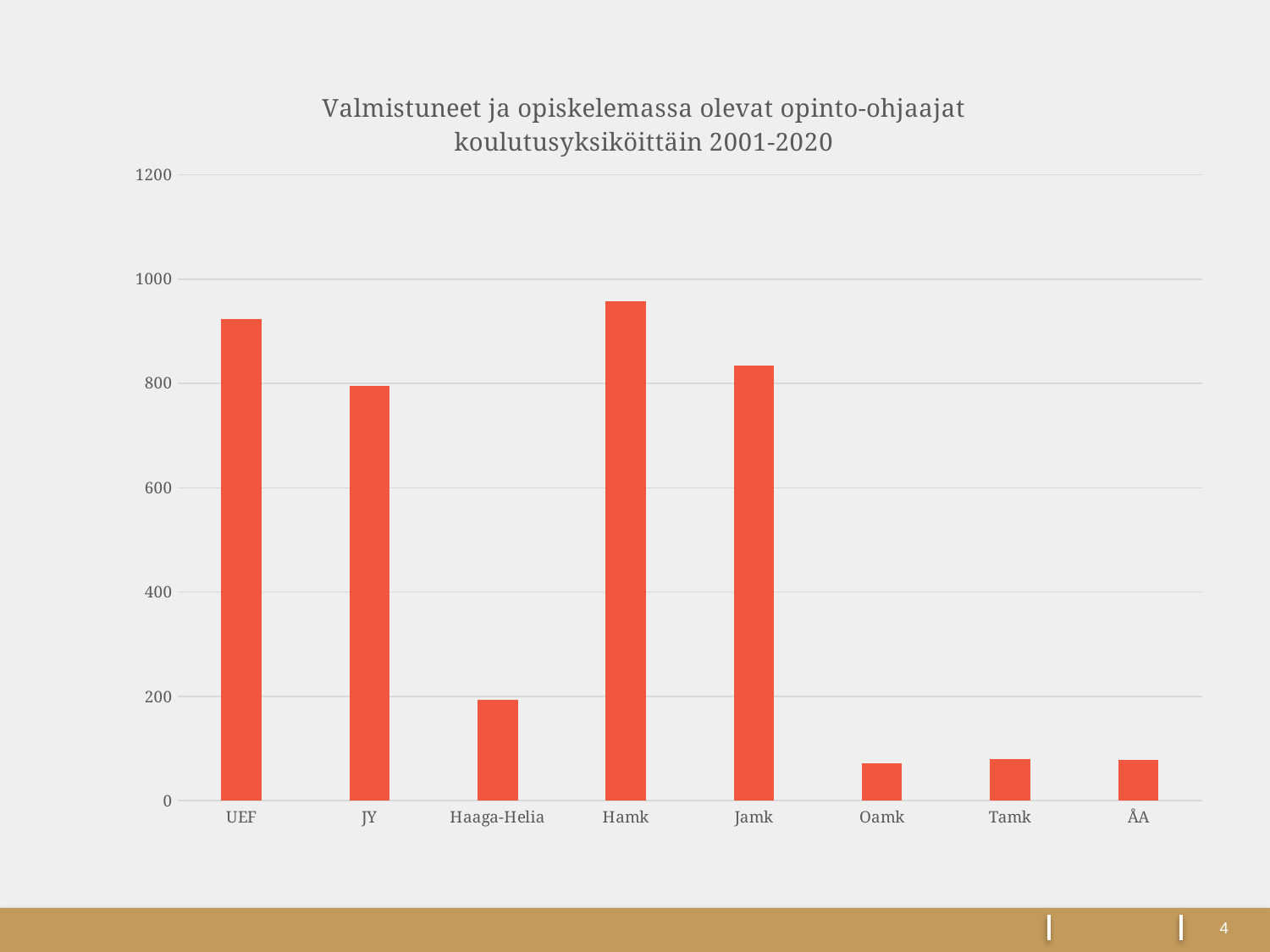
Is the value for Oamk greater or less than 200? less Which is larger, the value for UEF or the value for JY? UEF Is the value for Haaga-Helia greater or less than 400? less Is the value for UEF greater or less than 800? greater What is the title of the chart? Valmistuneet ja opiskelemassa olevat opinto-ohjaajat koulutusyksiköittäin 2001-2020 What kind of chart is shown on the slide? bar chart Which education unit has the highest bar? Hamk How many categories (education units) are shown on the x axis? 8 Which is larger, the value for Haaga-Helia or the value for Tamk? Haaga-Helia